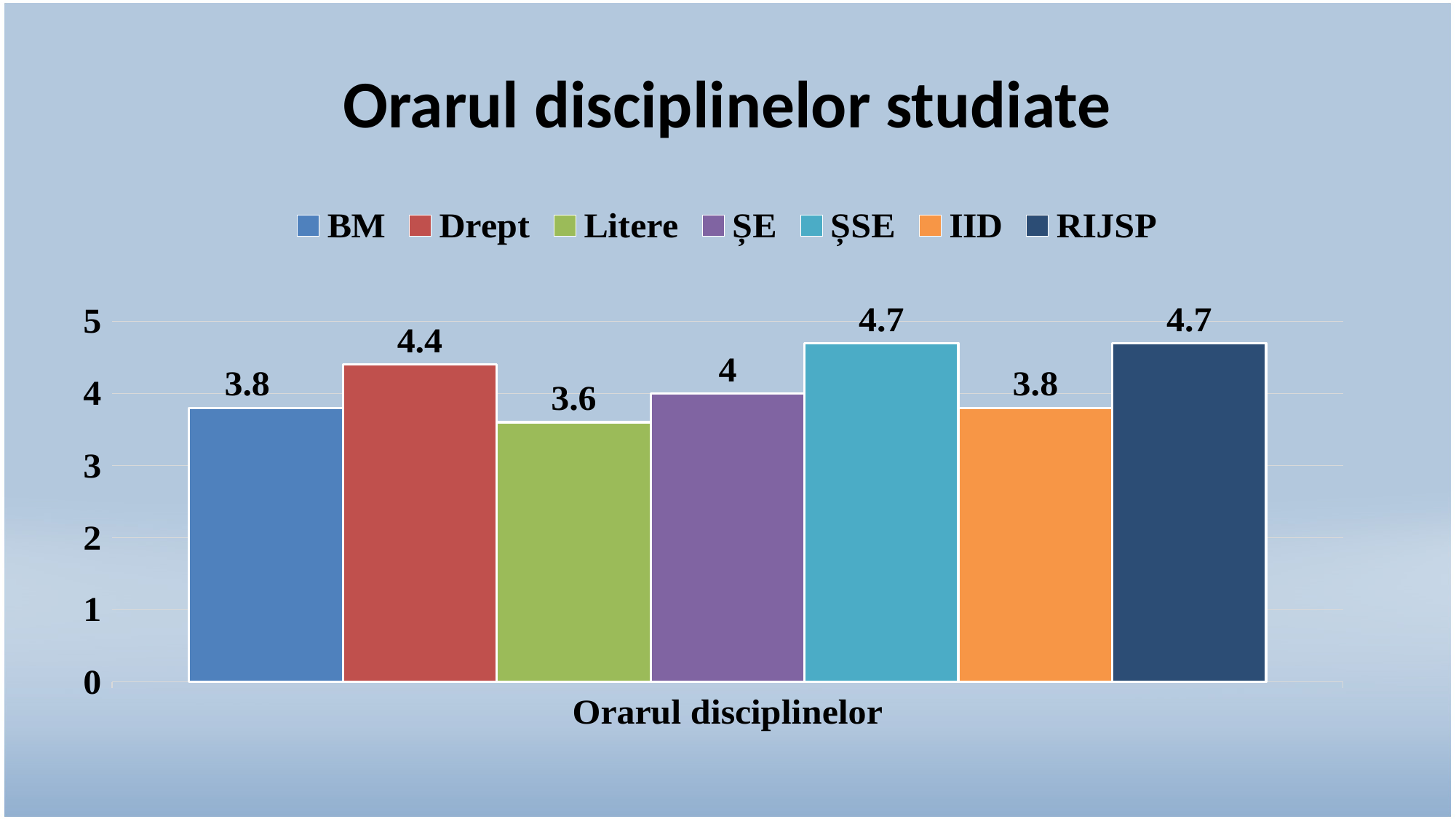
What kind of chart is shown on the slide? bar chart What is the difference between the values for ȘSE and Litere? 1.1 Which is larger, the value for Drept or the value for ȘE? Drept Which series has the lowest value? Litere What is the title of the chart? Orarul disciplinelor studiate How many series does the legend list? 7 What is the value for IID? 3.8 What is the difference between the values for Drept and BM? 0.6 What is the value for ȘE? 4 Is the value for Litere greater or less than 4? less What is the value for Litere? 3.6 What is the value for Drept? 4.4